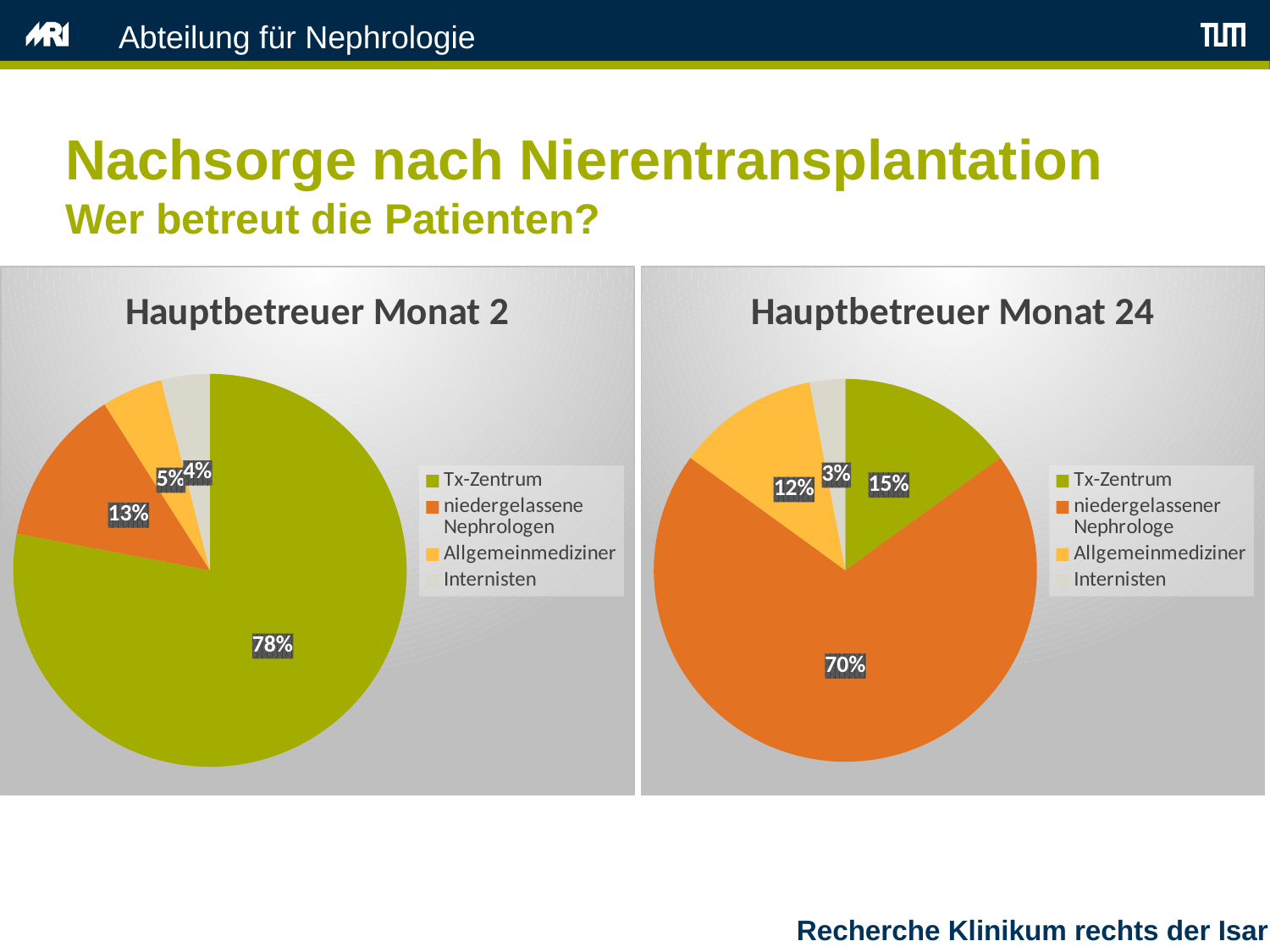
In the 'Hauptbetreuer Monat 24' chart, what is the difference between the Tx-Zentrum share and the Allgemeinmediziner share? 3% In the 'Hauptbetreuer Monat 2' chart, which is larger: niedergelassene Nephrologen or Internisten? niedergelassene Nephrologen In the 'Hauptbetreuer Monat 2' chart, what share is Allgemeinmediziner? 5% In the 'Hauptbetreuer Monat 24' chart, which category has the smallest slice? Internisten In the 'Hauptbetreuer Monat 24' chart, what share is niedergelassener Nephrologe? 70% What kind of chart is 'Hauptbetreuer Monat 2'? Pie chart What is the difference between the Tx-Zentrum share in the 'Hauptbetreuer Monat 2' chart and the Tx-Zentrum share in the 'Hauptbetreuer Monat 24' chart? 63% In the 'Hauptbetreuer Monat 2' chart, which category has the largest slice? Tx-Zentrum How many categories does the 'Hauptbetreuer Monat 24' chart show? 4 In the 'Hauptbetreuer Monat 24' chart, what share is Internisten? 3% In the 'Hauptbetreuer Monat 24' chart, what colour is the Allgemeinmediziner slice? Yellow In the 'Hauptbetreuer Monat 2' chart, what share is Tx-Zentrum? 78%